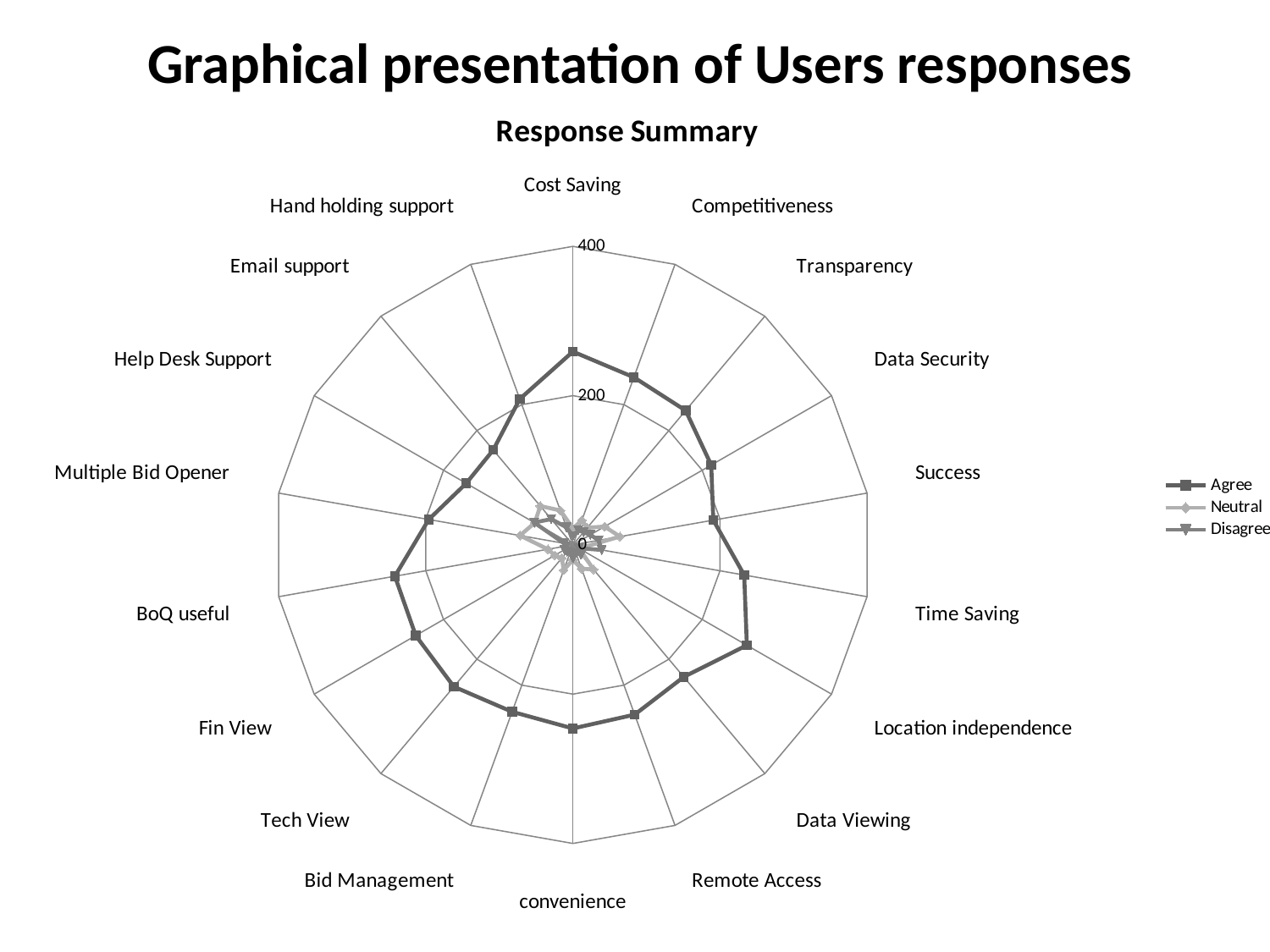
Is the Agree value for Cost Saving greater or less than 200? greater What is the title of the chart? Response Summary Which has the larger Agree value, Cost Saving or Help Desk Support? Cost Saving How many series does the legend list? 3 For Cost Saving, which series has the larger value, Agree or Neutral? Agree Is the Agree value for Location independence greater or less than 200? greater Which series are listed in the legend? Agree, Neutral, Disagree Is the Agree value for Help Desk Support greater or less than 200? less What kind of chart is shown on the slide? Radar chart How many categories are plotted around the radar chart? 18